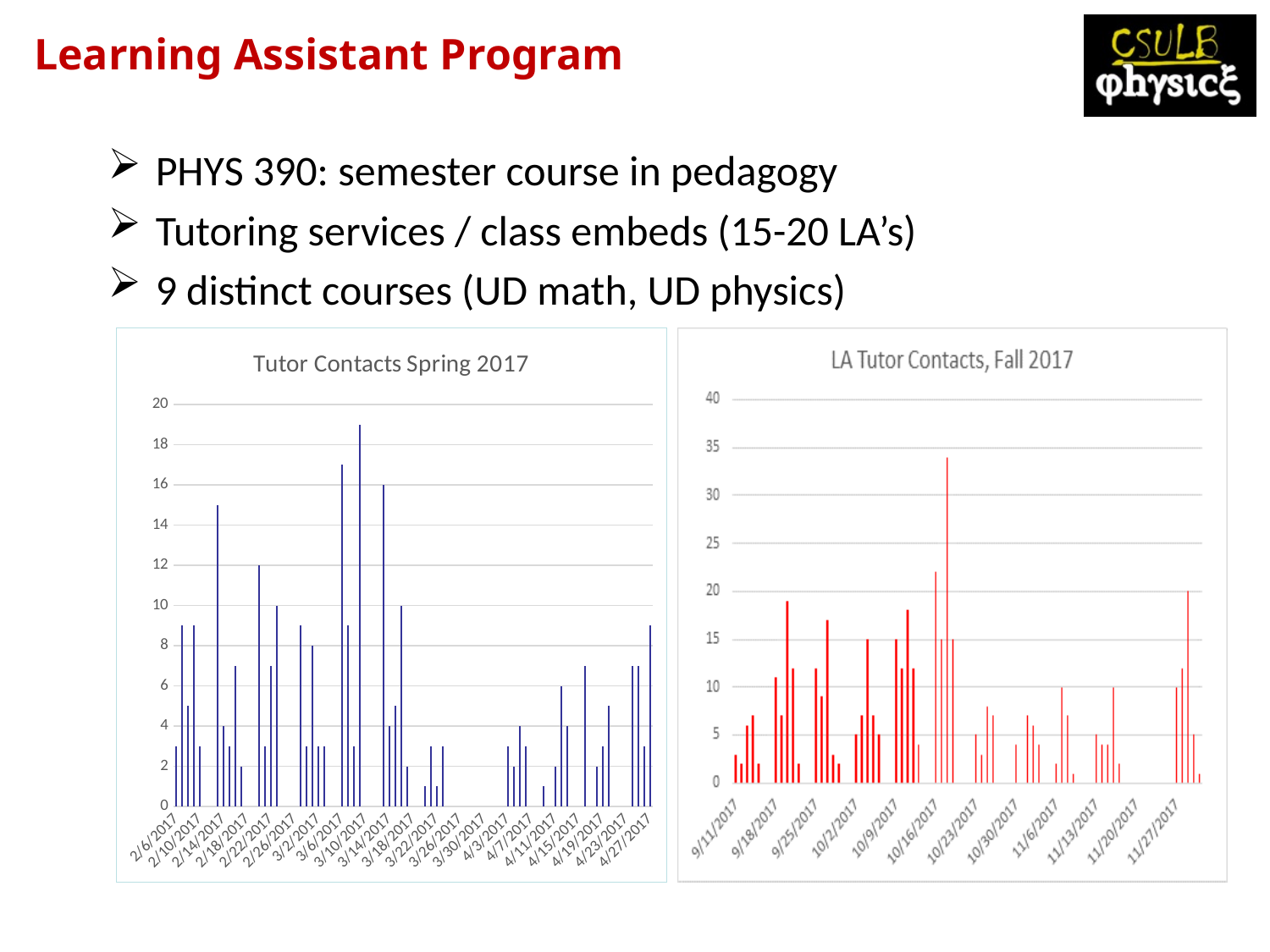
In the 'Tutor Contacts Spring 2017' chart, is the tallest bar greater or less than 15? greater What kind of chart is the 'LA Tutor Contacts, Fall 2017' chart on the right? bar chart What is the title of the chart on the right of the slide? LA Tutor Contacts, Fall 2017 What is the title of the chart on the left of the slide? Tutor Contacts Spring 2017 In the 'LA Tutor Contacts, Fall 2017' chart, is the tallest bar greater or less than 30? greater In the 'LA Tutor Contacts, Fall 2017' chart, is the tallest bar greater or less than 35? less Which chart has the taller maximum bar, 'Tutor Contacts Spring 2017' or 'LA Tutor Contacts, Fall 2017'? LA Tutor Contacts, Fall 2017 What kind of chart is the 'Tutor Contacts Spring 2017' chart on the left? bar chart